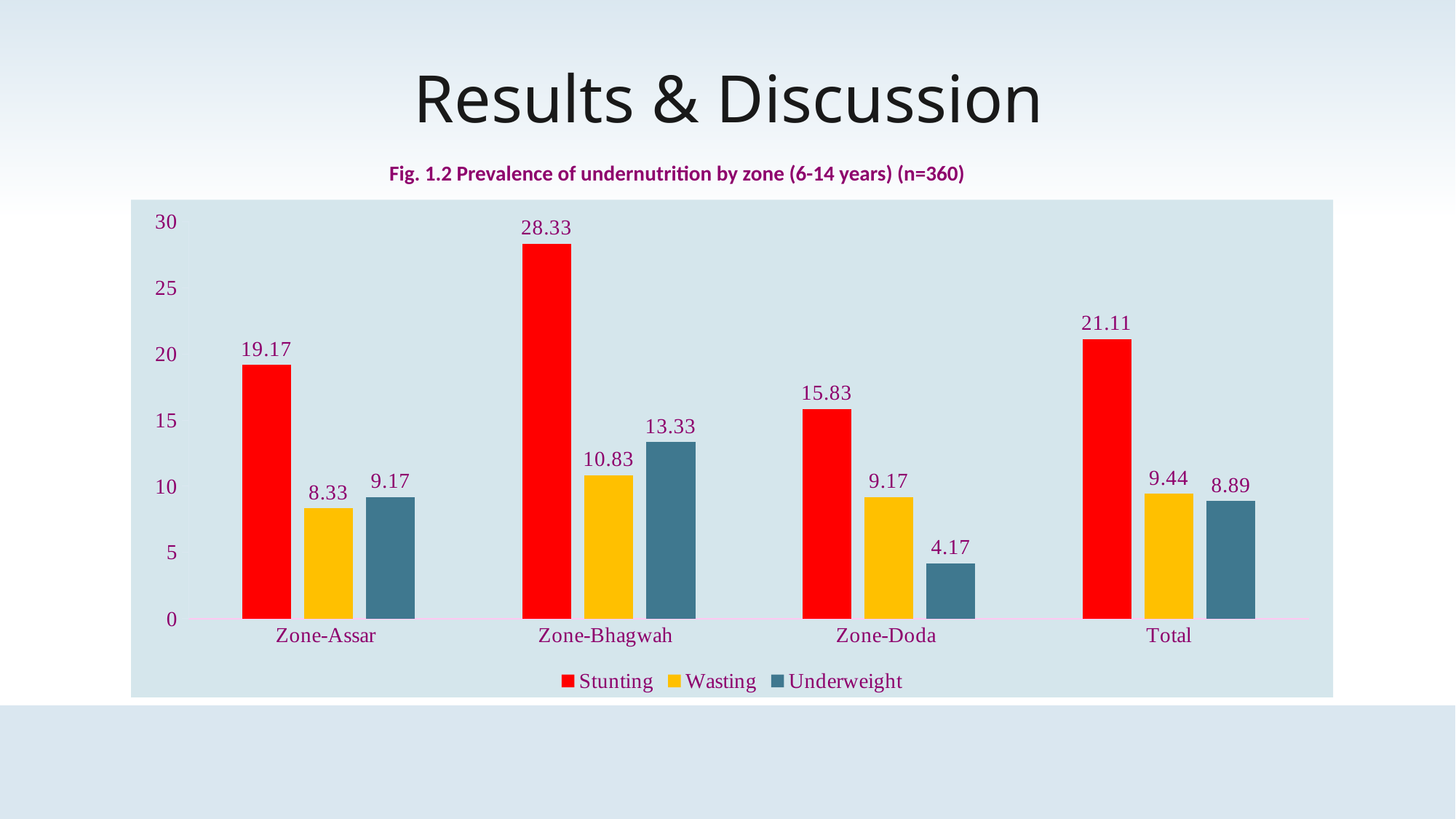
How many series does the legend list? 3 Which category has the lowest Underweight value? Zone-Doda How many categories are shown on the x axis? 4 Which zone has the highest Stunting value? Zone-Bhagwah What colour represents the Wasting series? Yellow Which is larger for Zone-Bhagwah: Wasting or Underweight? Underweight What is the Stunting value for Zone-Bhagwah? 28.33 What is the Stunting value for Total? 21.11 What kind of chart is shown on the slide? Bar chart What is the difference between the Stunting values for Zone-Bhagwah and Zone-Assar? 9.16 What is the Wasting value for Zone-Assar? 8.33 What is the Underweight value for Zone-Doda? 4.17